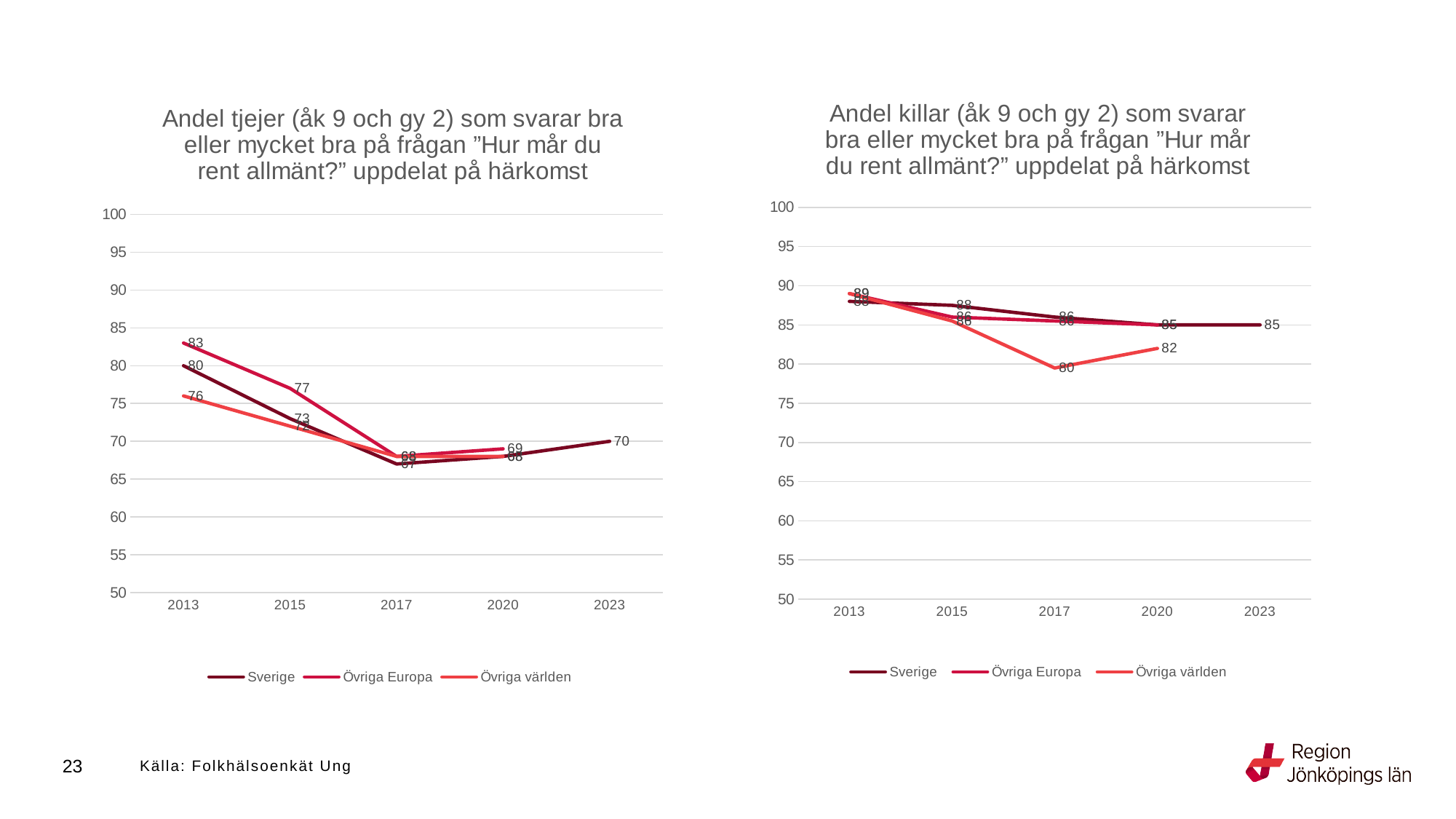
In the left chart (Andel tjejer), does the Sverige line rise or fall from 2013 to 2017? Fall In the left chart (Andel tjejer), which series has the highest value in 2013? Övriga Europa What kind of chart is the left chart, 'Andel tjejer (åk 9 och gy 2) som svarar bra eller mycket bra...'? Line chart In the left chart (Andel tjejer), what is the difference between Övriga Europa and Övriga världen in 2013? 7 In the right chart (Andel killar), what is the value for Övriga världen in 2017? 80 In the left chart (Andel tjejer), what is the value for Övriga Europa in 2013? 83 How many years are shown on the x axis of the right chart (Andel killar)? 5 How many series does the legend of the left chart (Andel tjejer) list? 3 In the right chart (Andel killar), which series has the lowest value in 2017? Övriga världen In the left chart (Andel tjejer), what is the value for Sverige in 2013? 80 In the left chart (Andel tjejer), what is the value for Övriga världen in 2013? 76 In the left chart (Andel tjejer), what is the value for Övriga Europa in 2015? 77